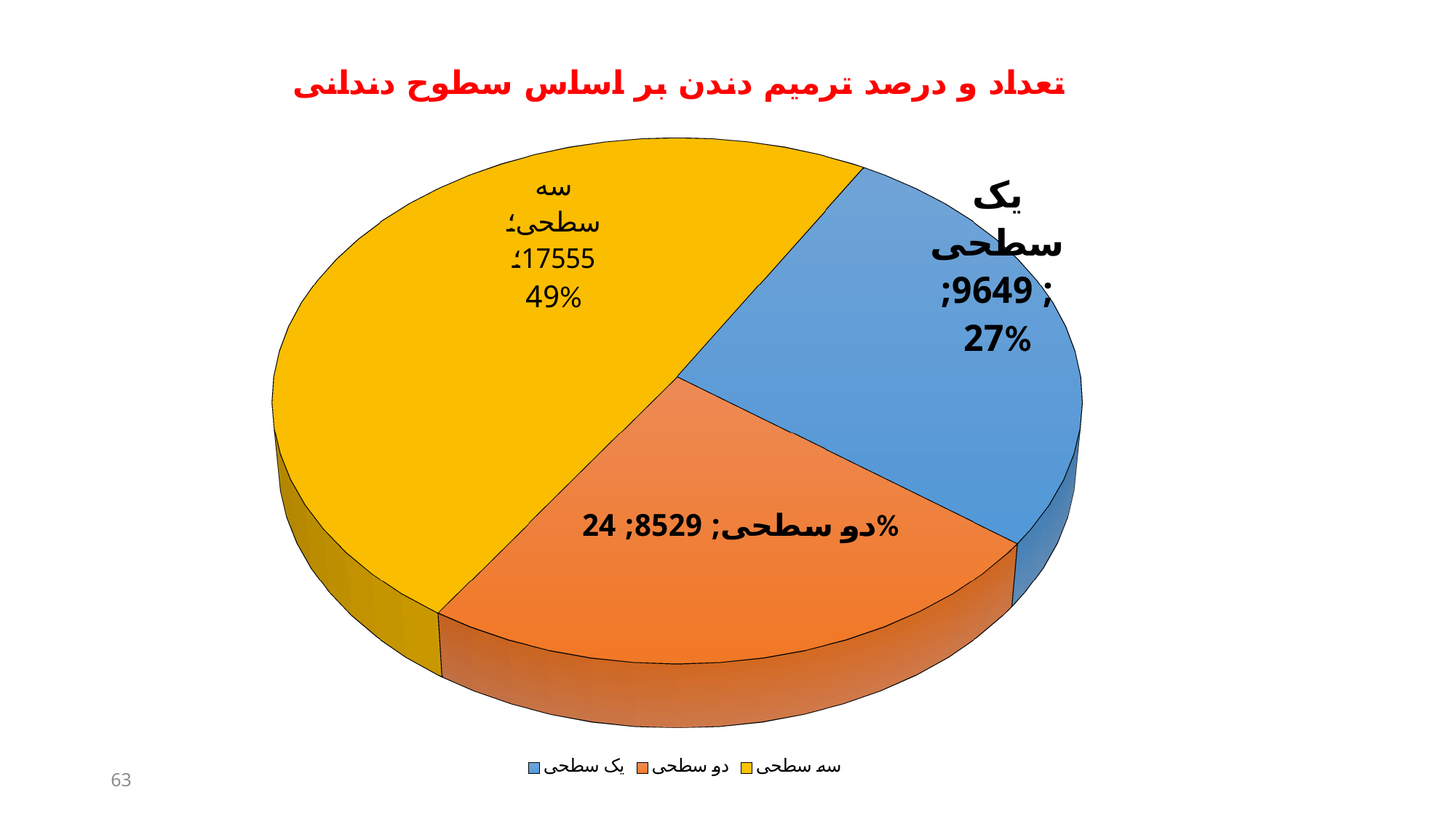
Which category has the smallest slice? دو سطحی What share of the pie does the سه سطحی slice represent? 49% What is the value for the سه سطحی slice? 17555 What kind of chart is shown on the slide? Pie chart Which is larger, the value for یک سطحی or the value for دو سطحی? یک سطحی What share of the pie does the دو سطحی slice represent? 24% What is the value for the یک سطحی slice? 9649 What is the value for the دو سطحی slice? 8529 Which category has the largest slice? سه سطحی How many slices does the pie chart have? 3 What is the difference between the values for سه سطحی and یک سطحی? 7906 What colour is the سه سطحی slice? Yellow